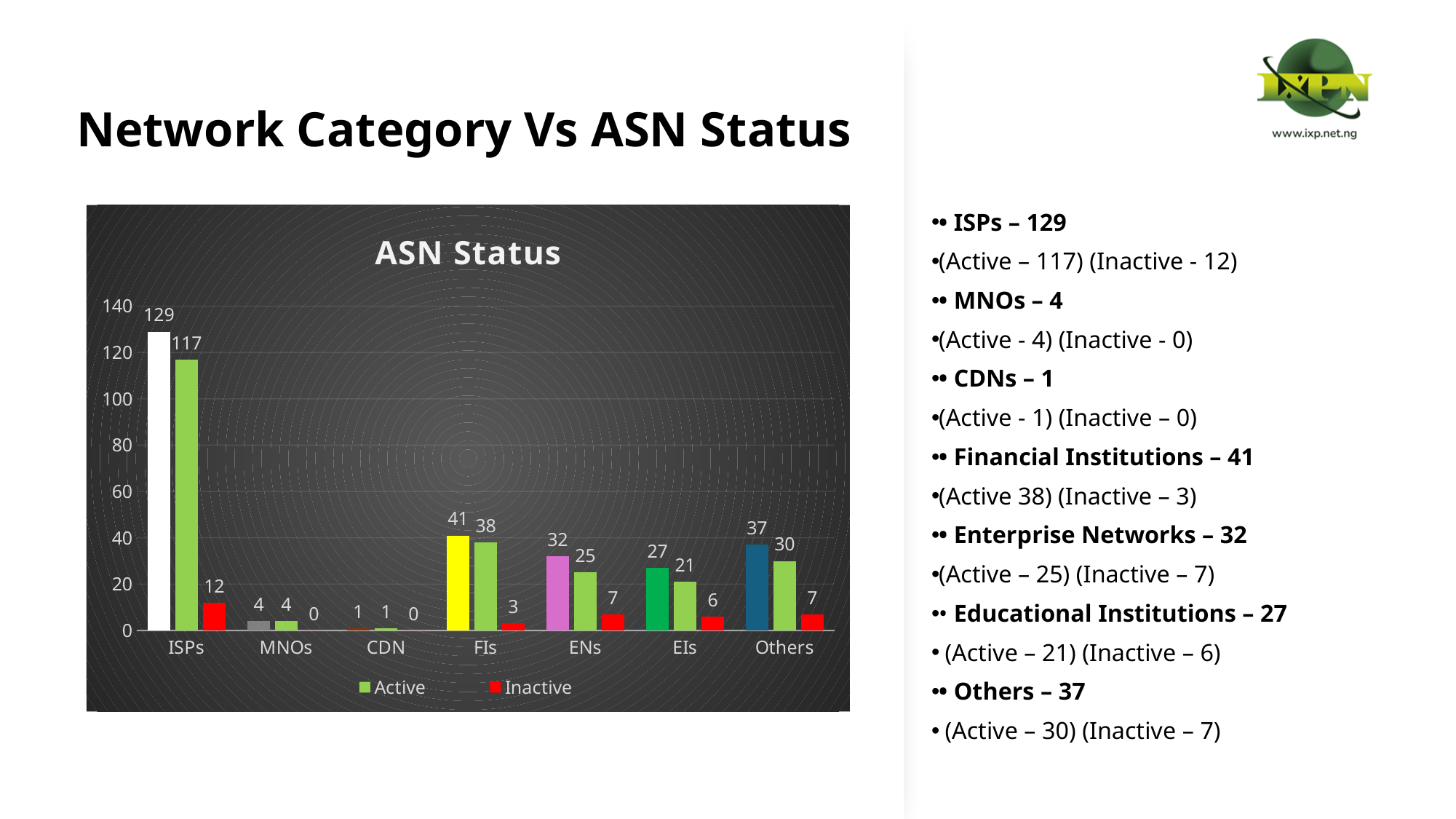
What type of chart is the ASN Status chart? bar chart What is the Active value for FIs in the ASN Status chart? 38 What colour are the Inactive bars in the ASN Status chart? red What is the Inactive value for ENs in the ASN Status chart? 7 How many series does the legend of the ASN Status chart list? 2 What is the difference between the Active and Inactive values for EIs in the ASN Status chart? 15 Which category has the lowest Active value in the ASN Status chart? CDN Which is larger in the ASN Status chart: the Active value for ENs or the Active value for Others? Others What is the Active value for ISPs in the ASN Status chart? 117 How many categories are shown on the x axis of the ASN Status chart? 7 Is the Active value for ISPs greater or less than 100 in the ASN Status chart? greater Which category has the highest Active value in the ASN Status chart? ISPs